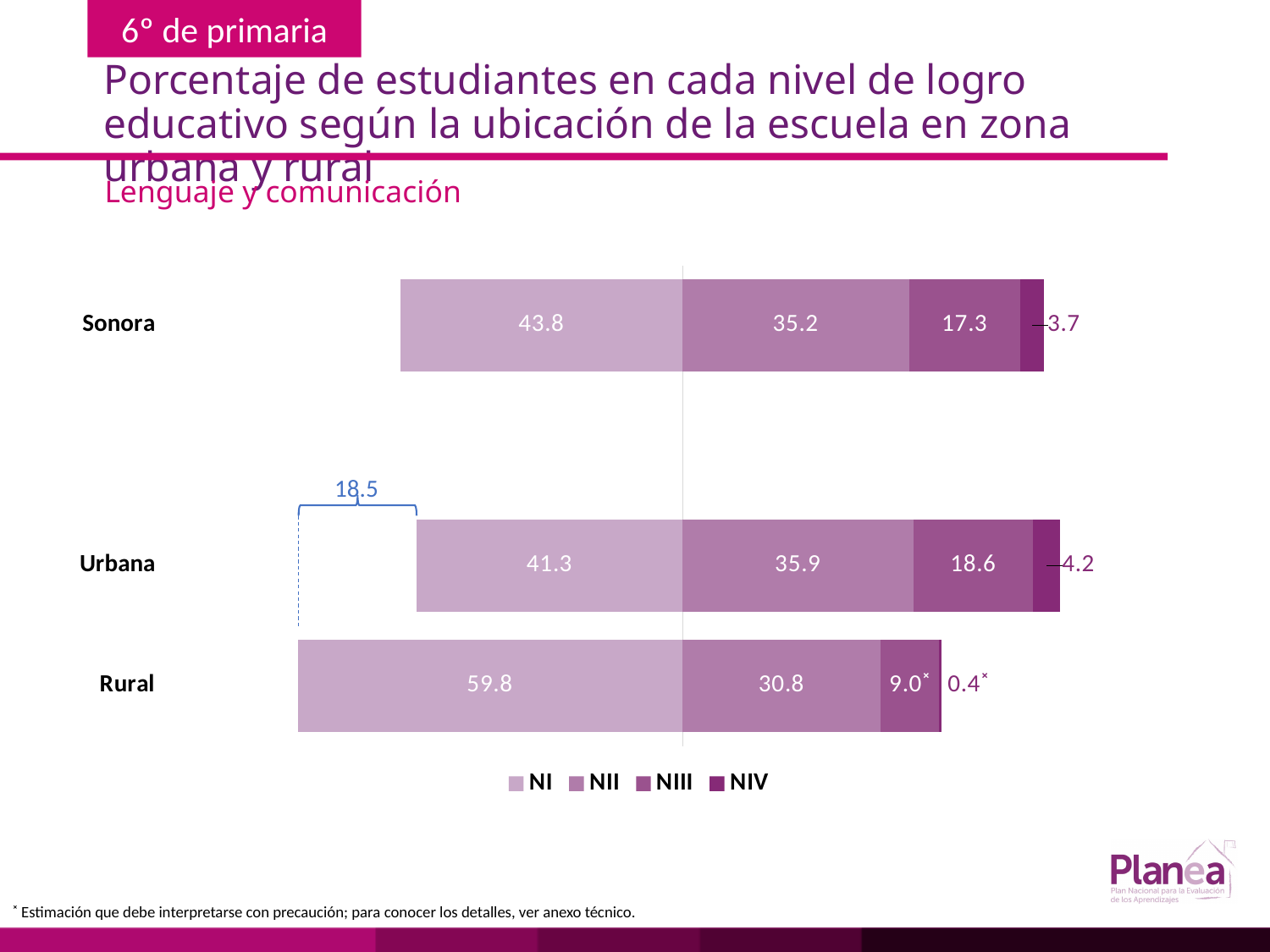
What percentage of Rural students are at level NI? 59.8 What kind of chart is shown on the slide? Stacked bar chart What is the NIII value for Rural? 9.0 Which has a larger NIII value, Sonora or Urbana? Urbana What is the NIV value for Urbana? 4.2 What is the difference between the NI values for Rural and Urbana? 18.5 What are the legend entries of the chart? NI, NII, NIII, NIV How many series does the legend list? 4 What is the NII value for Sonora? 35.2 How many categories are shown on the chart? 3 Which category has the highest NI value? Rural Which category has the lowest NIV value? Rural